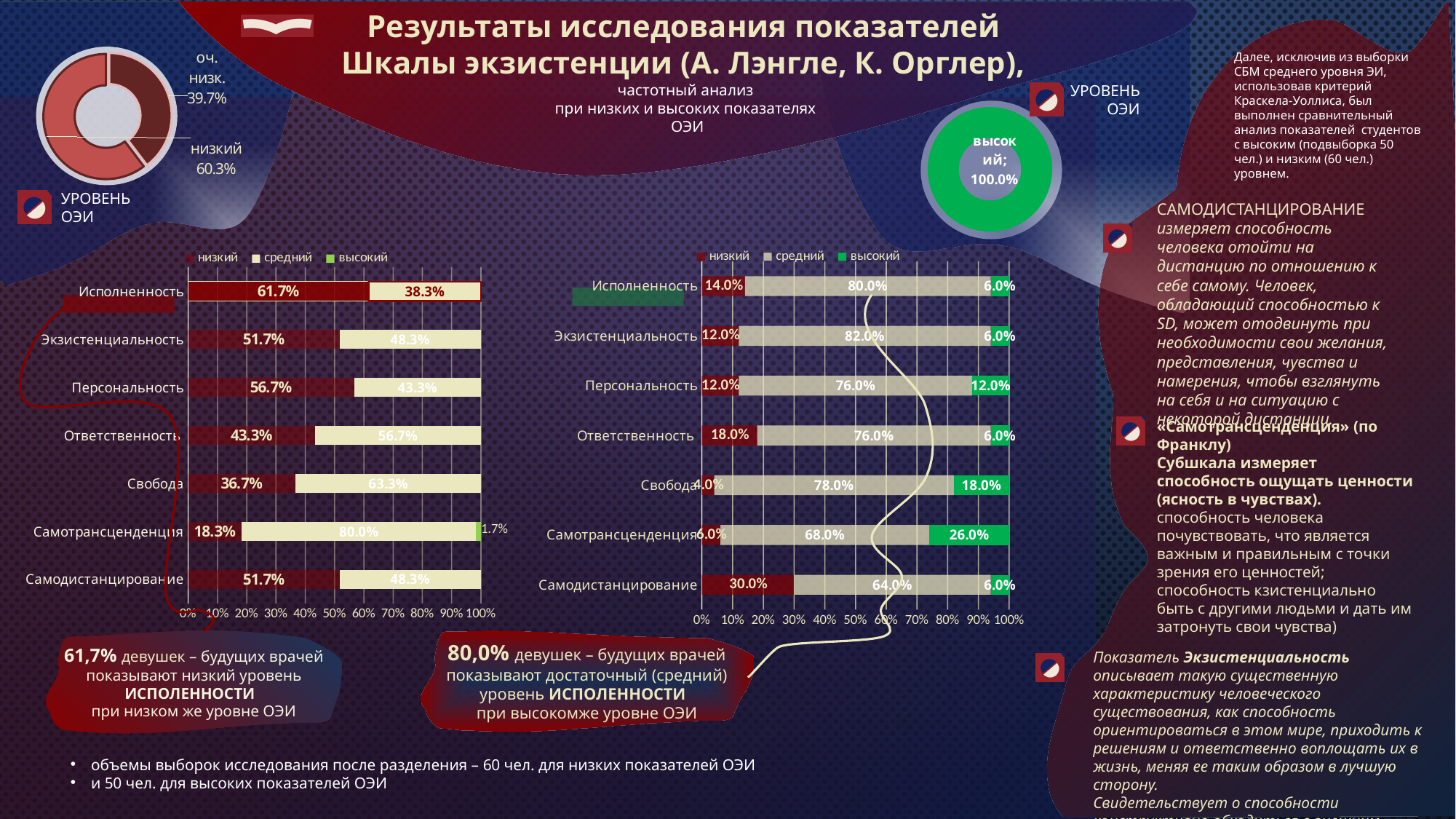
In the right stacked bar chart, which category has the highest "низкий" value? Самодистанцирование In the top-left doughnut chart, what share is labelled "низкий"? 60.3% In the top-right doughnut chart, what percentage is shown for "высокий"? 100.0% In the right stacked bar chart, what is the difference between the "средний" values for Экзистенциальность and Самодистанцирование? 18.0% In the left stacked bar chart, how many series does the legend list? 3 In the left stacked bar chart, which category has the lowest "низкий" value? Самотрансценденция In the right stacked bar chart, how many categories are plotted? 7 In the top-left doughnut chart, what share is labelled "оч. низк."? 39.7% In the left stacked bar chart, which category has the highest "средний" value? Самотрансценденция In the left stacked bar chart, what is the "низкий" value for Исполненность? 61.7% What type of chart is the left chart with the categories Исполненность to Самодистанцирование? Stacked bar chart In the right stacked bar chart, what is the "высокий" value for Самотрансценденция? 26.0%